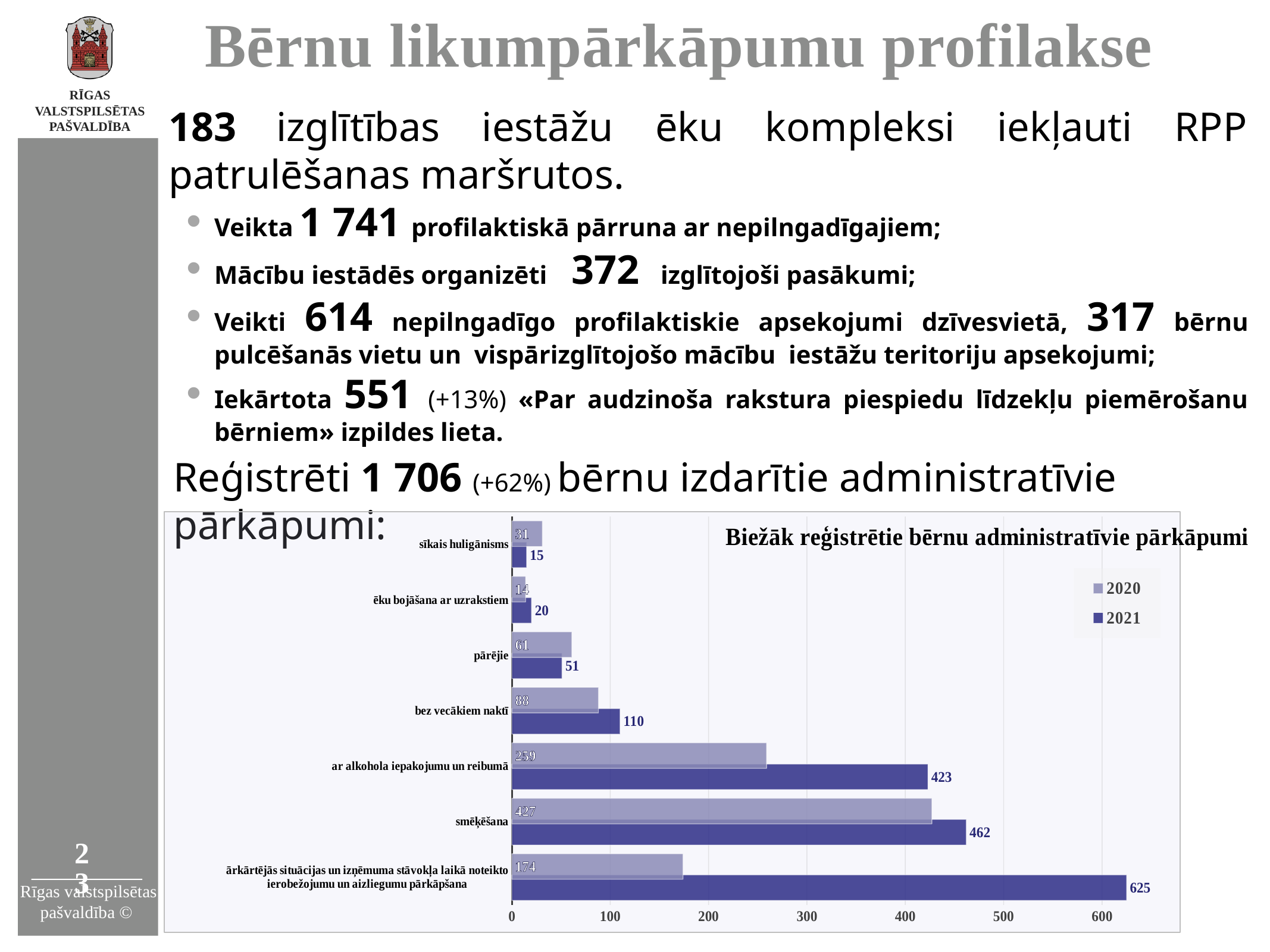
How many categories are shown on the chart? 7 Which category has the highest 2021 value? ārkārtējās situācijas un izņēmuma stāvokļa laikā noteikto ierobežojumu un aizliegumu pārkāpšana What is the 2021 value for smēķēšana? 462 How many series does the legend list? 2 For sīkais huligānisms, which year has the larger value, 2020 or 2021? 2020 Which category has the lowest 2020 value? ēku bojāšana ar uzrakstiem What is the difference between the 2021 and 2020 values for ārkārtējās situācijas un izņēmuma stāvokļa laikā noteikto ierobežojumu un aizliegumu pārkāpšana? 451 Is the 2020 value for smēķēšana greater or less than 400? greater What is the title of the chart? Biežāk reģistrētie bērnu administratīvie pārkāpumi What kind of chart is shown on the slide? bar chart What is the 2020 value for ar alkohola iepakojumu un reibumā? 259 What is the 2021 value for bez vecākiem naktī? 110